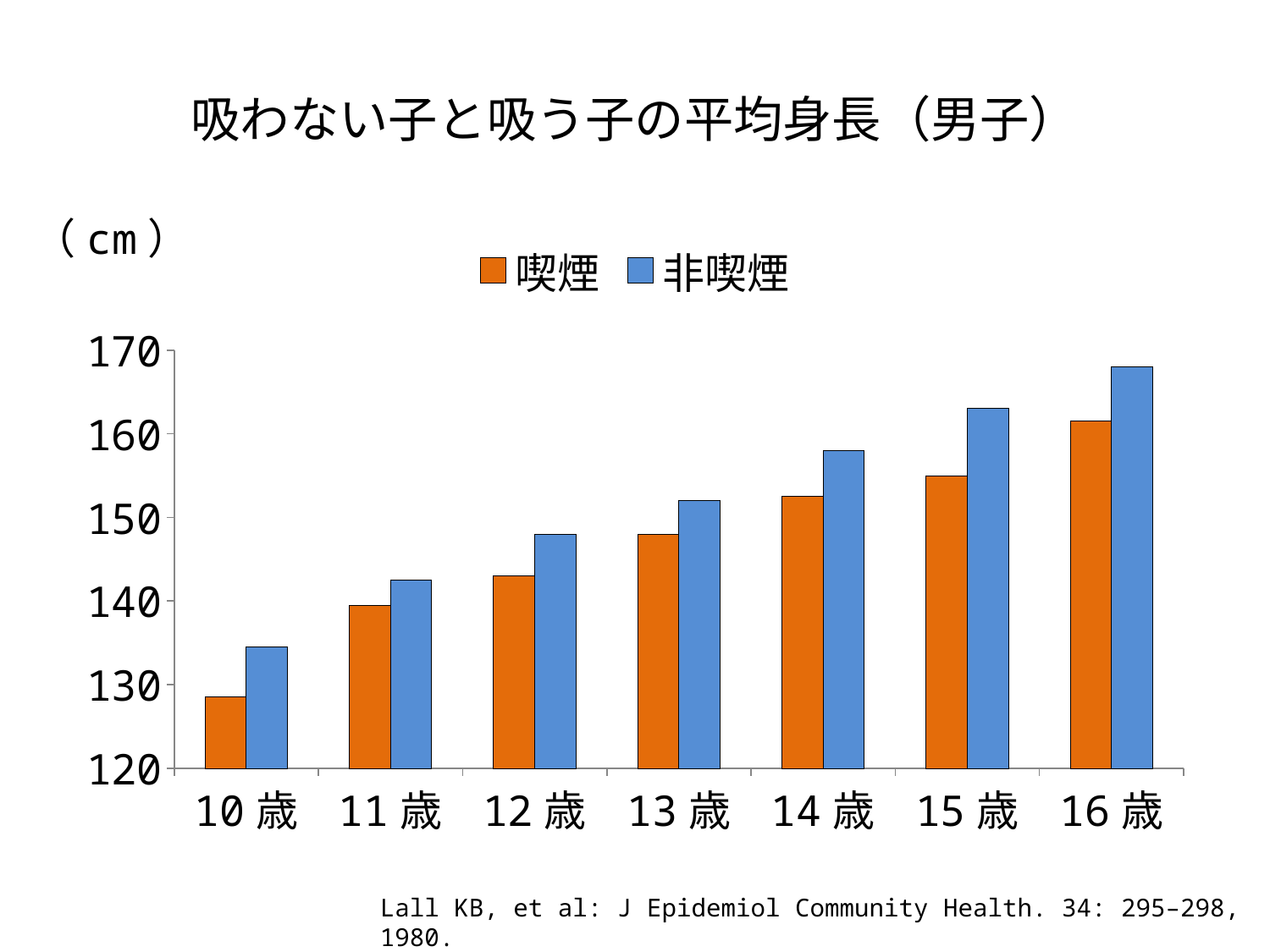
How many series does the legend list? 2 Which age group has the tallest bar for 非喫煙? 16歳 What kind of chart is shown on the slide? bar chart Which age group has the shortest bar for 喫煙? 10歳 Is the value for 非喫煙 at 16歳 greater or less than 160? greater Is the value for 非喫煙 at 14歳 greater or less than 150? greater Is the value for 非喫煙 at 10歳 greater or less than 130? greater What unit is shown for the y axis? cm How many age categories are shown on the x axis? 7 Do the 喫煙 values rise or fall as age increases along the x axis? rise At 13歳, which is larger, 喫煙 or 非喫煙? 非喫煙